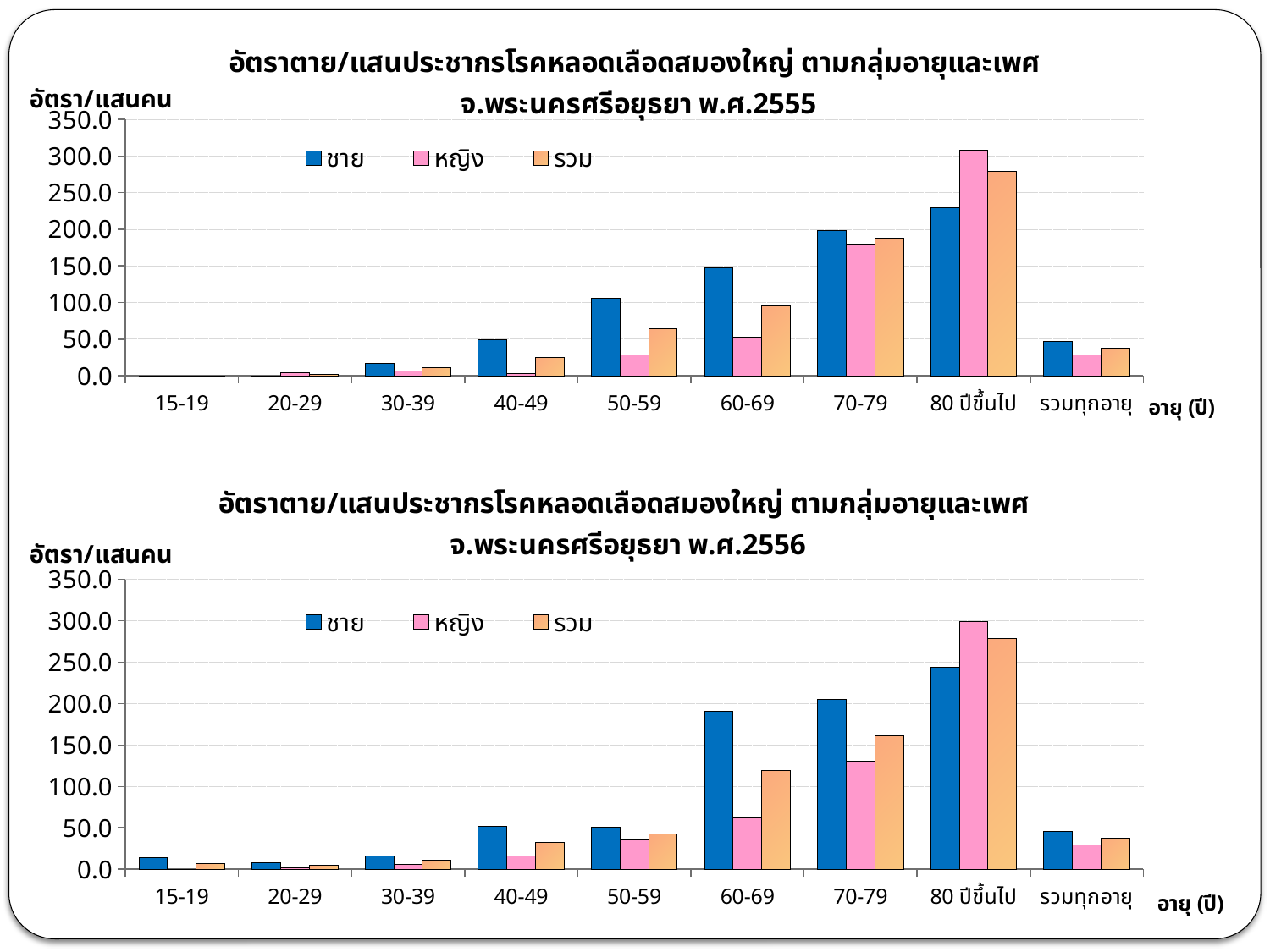
In the bottom chart (พ.ศ.2556), is the value for ชาย in the 60-69 group greater or less than 150? greater In the top chart (พ.ศ.2555), is the value for ชาย in the 60-69 group greater or less than 100? greater In the top chart (พ.ศ.2555), do the values for ชาย rise or fall from 15-19 to 80 ปีขึ้นไป? rise In the top chart (พ.ศ.2555), which age group has the highest value for ชาย? 80 ปีขึ้นไป In the top chart (พ.ศ.2555), for the 70-79 group, which is larger: ชาย or หญิง? ชาย In the bottom chart (พ.ศ.2556), for the 60-69 group, which is larger: ชาย or หญิง? ชาย How many age-group categories are shown on the x axis of the bottom chart (พ.ศ.2556)? 9 What kind of chart is the top chart (พ.ศ.2555)? bar chart In the top chart (พ.ศ.2555), is the value for หญิง in the 80 ปีขึ้นไป group greater or less than 250? greater How many series does the legend of the top chart (พ.ศ.2555) list? 3 In the bottom chart (พ.ศ.2556), which series has the highest value in the 80 ปีขึ้นไป group? หญิง What is the y-axis label of the bottom chart (พ.ศ.2556)? อัตรา/แสนคน